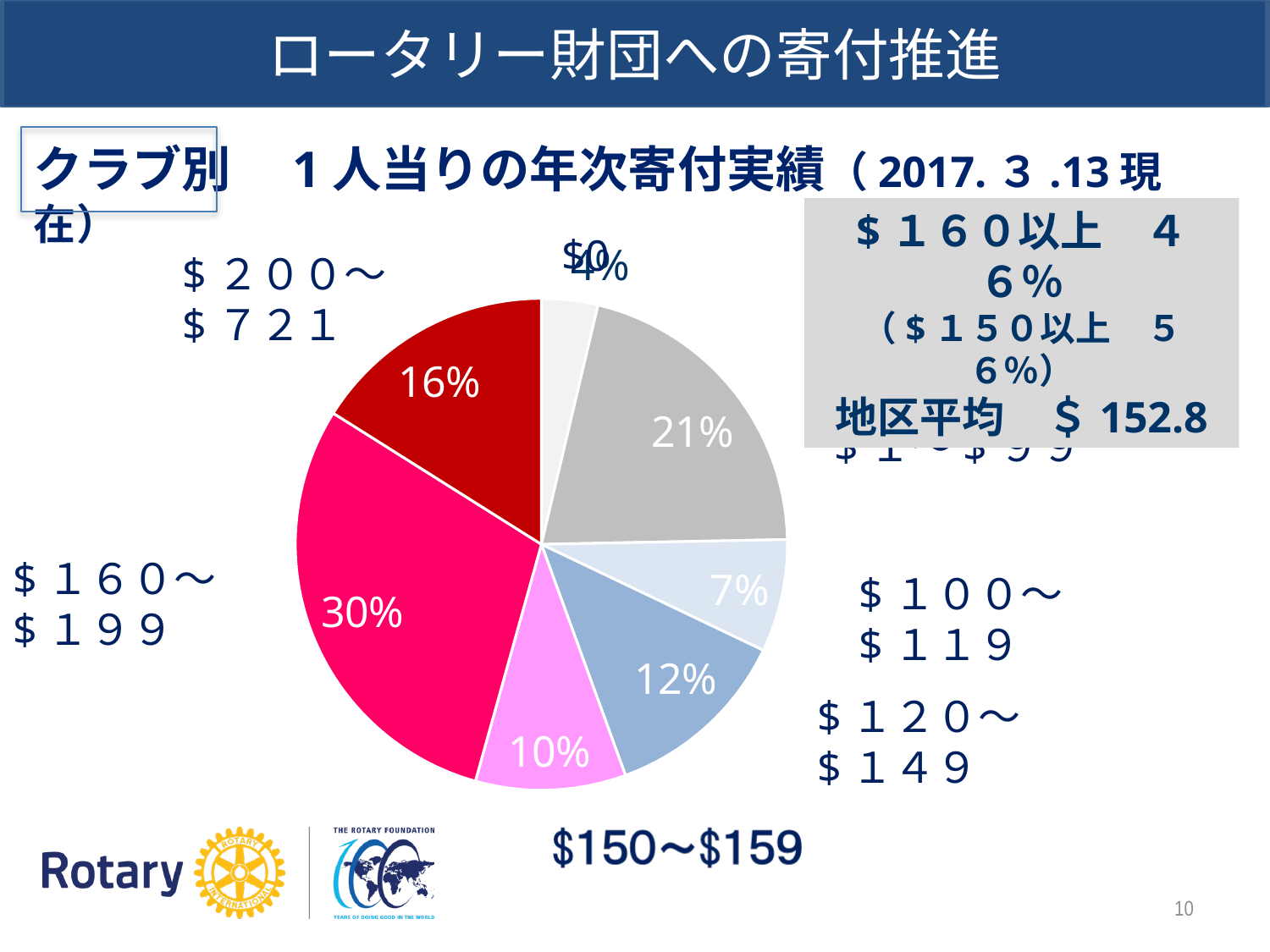
What percentage of the pie chart is the $200～$721 slice? 16% What percentage of the pie chart is the $150～$159 slice? 10% What percentage of the pie chart is the $160～$199 slice? 30% Which category has the largest slice of the pie chart? $160～$199 How many percentage points larger is the $160～$199 slice than the $200～$721 slice? 14 percentage points What is the combined share of the $160～$199 and $200～$721 slices? 46% What percentage of the pie chart is the $100～$119 slice? 7% What type of chart is shown on the slide? Pie chart Which slice is larger, $120～$149 or $100～$119? $120～$149 What percentage of the pie chart is the $120～$149 slice? 12% How many slices does the pie chart have? 7 Which category has the smallest slice of the pie chart? $0